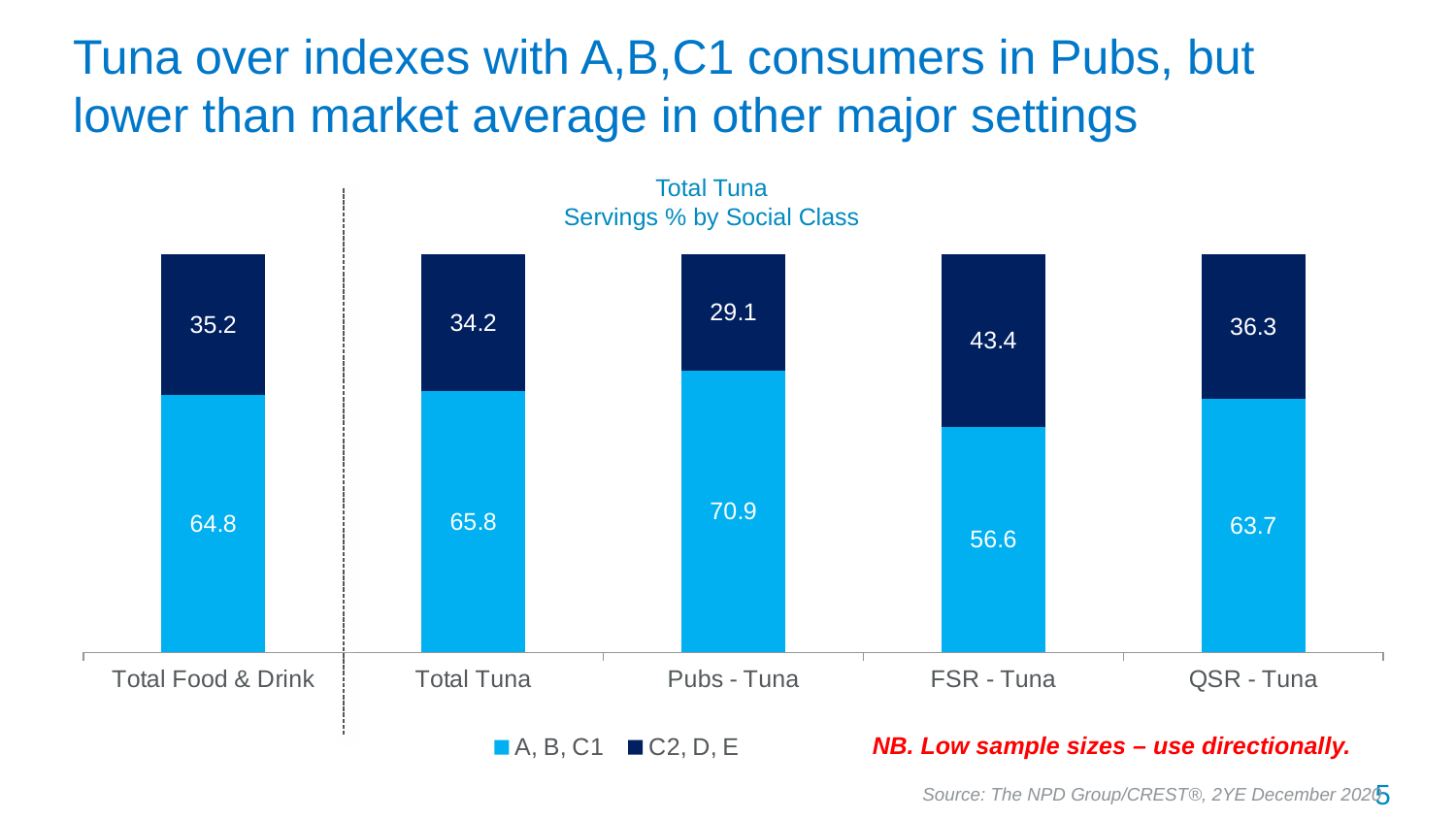
How many categories are shown on the x axis? 5 What is the A, B, C1 value for Total Food & Drink? 64.8 Which category has the lowest A, B, C1 value? FSR - Tuna What is the difference between the A, B, C1 values for Pubs - Tuna and FSR - Tuna? 14.3 What is the A, B, C1 value for Pubs - Tuna? 70.9 How many series does the legend list? 2 What is the total of the stacked bar for Total Tuna? 100 Which is larger, the C2, D, E value for QSR - Tuna or for Total Tuna? QSR - Tuna What kind of chart is shown? Stacked bar chart What is the title of the chart? Total Tuna Servings % by Social Class Which category has the highest A, B, C1 value? Pubs - Tuna What is the C2, D, E value for FSR - Tuna? 43.4